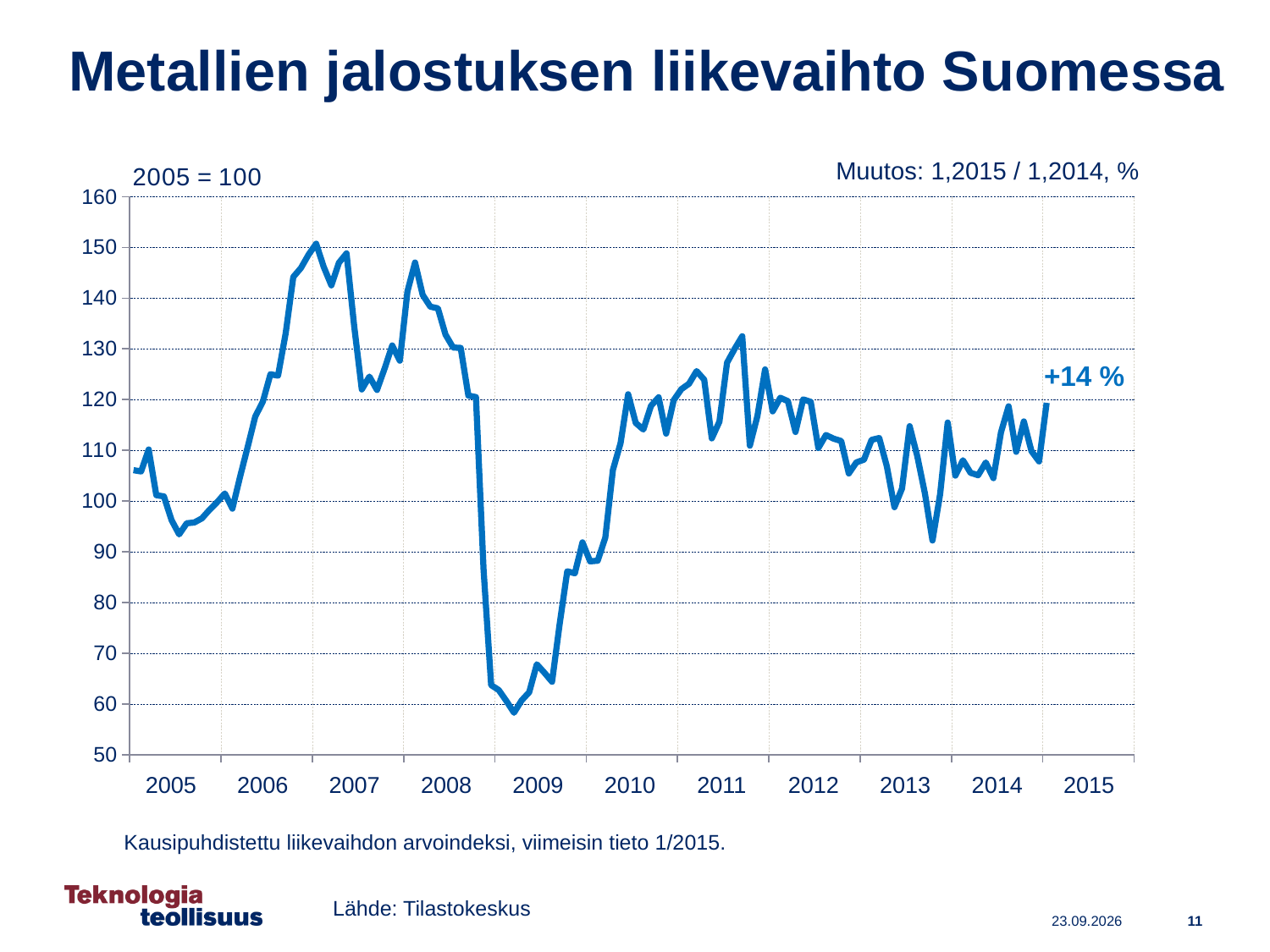
Is the value of the index at the peak in late 2006 greater or less than 140? greater What is the highest value shown on the y axis? 160 Is the value of the index at its lowest point in 2009 greater or less than 70? less Which is higher: the index peak in 2006–2007 or the index peak in 2011? the 2006–2007 peak How many series are plotted in the chart? 1 Is the value of the index at the start of 2005 greater or less than 100? greater What is the base year and value of the index, as stated above the chart? 2005 = 100 Does the index rise or fall between mid-2008 and early 2009? fall Does the index rise or fall between early 2009 and early 2010? rise How many year labels are shown on the x axis? 11 What percentage change is annotated at the end of the line (Muutos 1,2015 / 1,2014)? +14 % What kind of chart is shown on the slide? line chart